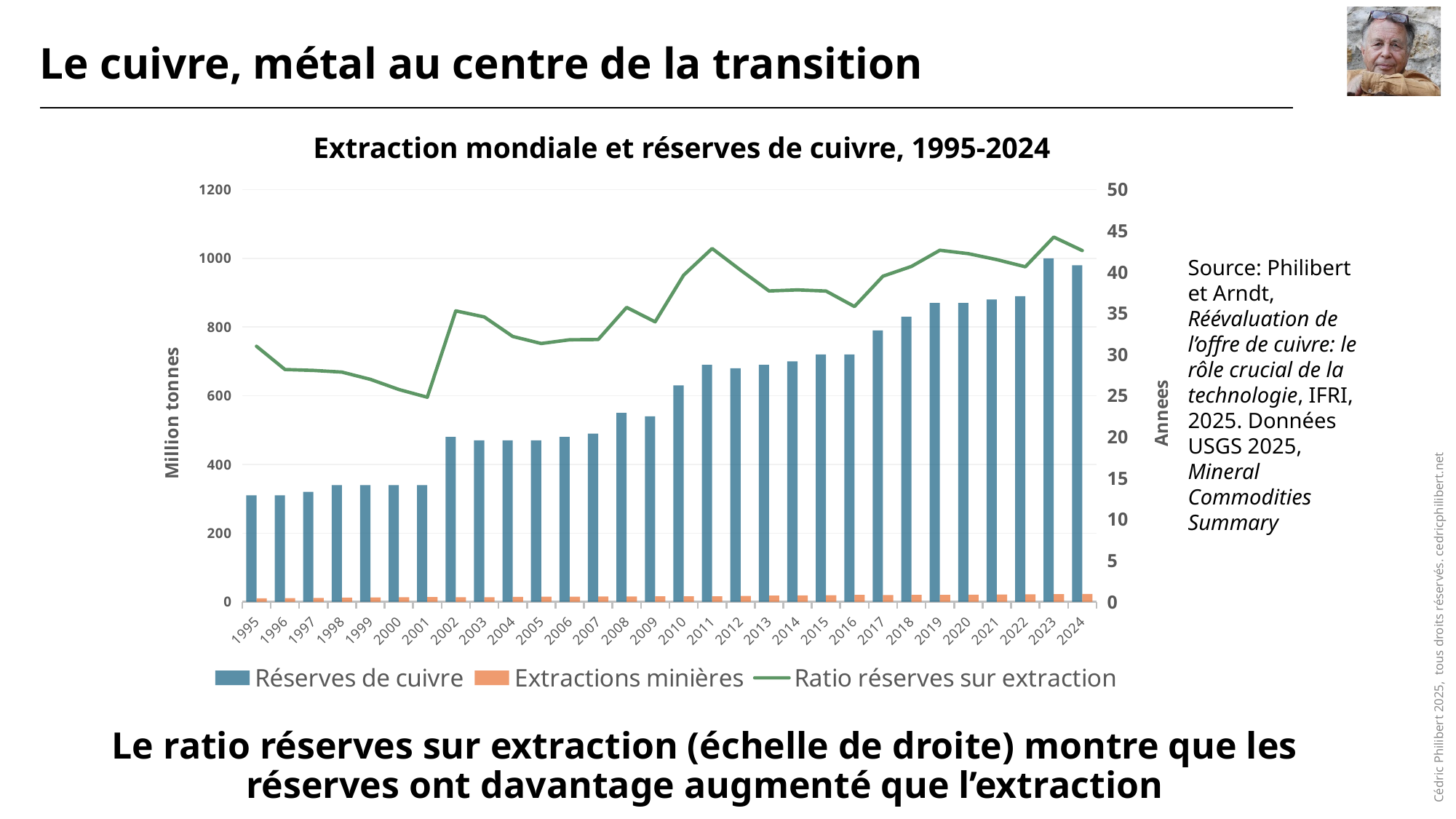
How many series does the chart legend list? 3 Which series is plotted as a green line? Ratio réserves sur extraction Which year has the larger value of Réserves de cuivre, 2000 or 2010? 2010 Is the value of Réserves de cuivre for 1995 greater or less than 400? less Is the Ratio réserves sur extraction for 2001 greater or less than 30? less Is the value of Réserves de cuivre for 2023 greater or less than 800? greater What kind of chart is shown on the slide? A combined bar and line chart In which year is the Ratio réserves sur extraction at its lowest? 2001 Do the Réserves de cuivre bars generally rise or fall from 1995 to 2024? Rise How many years are shown on the x axis of the chart? 30 What is the title of the chart? Extraction mondiale et réserves de cuivre, 1995-2024